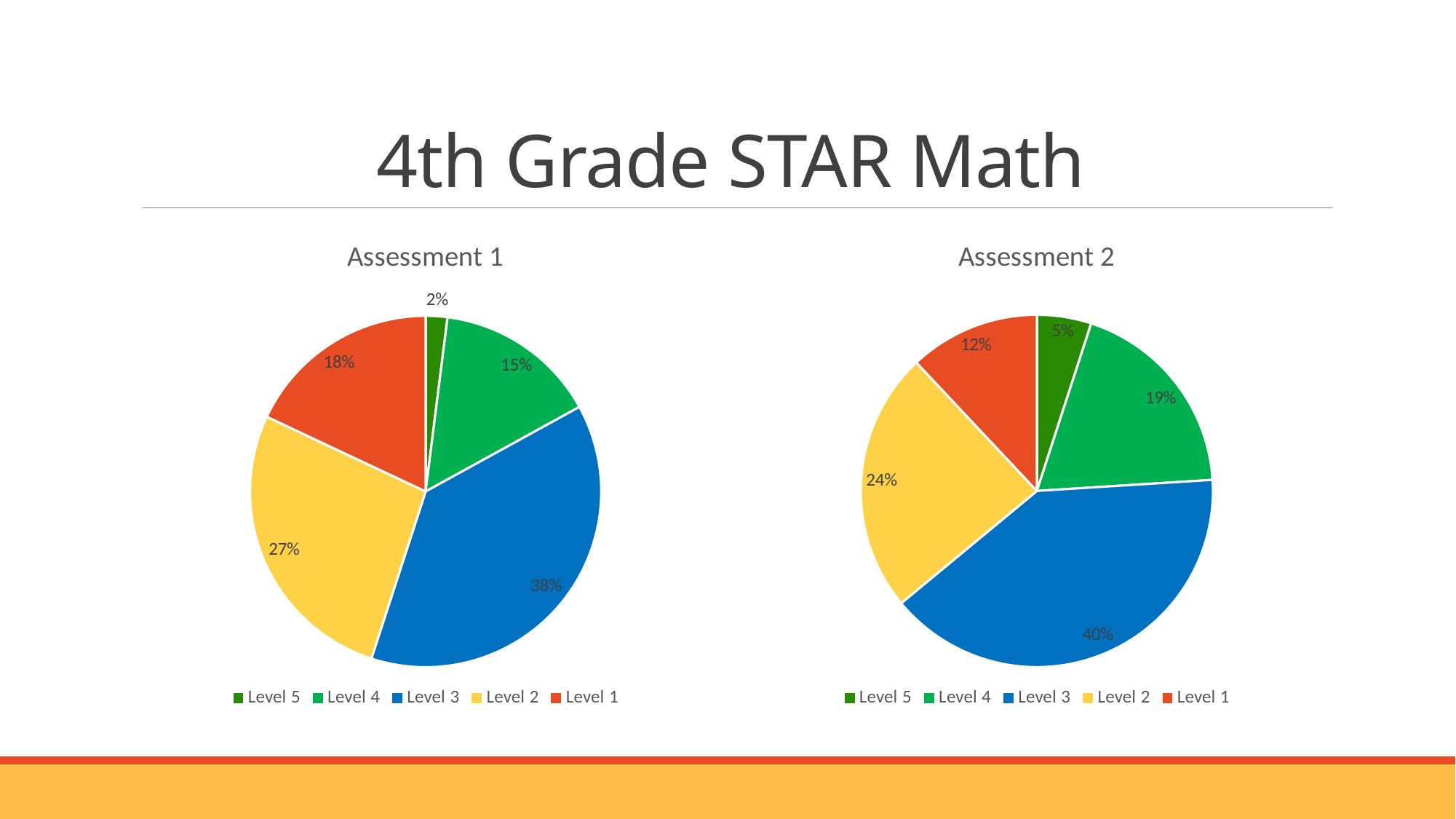
Which is larger: Level 4 in Assessment 1 or Level 4 in Assessment 2? Level 4 in Assessment 2 In the Assessment 2 chart, what is the difference between the Level 3 and Level 4 percentages? 21% In the Assessment 1 chart, what is the difference between the Level 2 and Level 1 percentages? 9% In the Assessment 2 chart, what percentage is shown for Level 2? 24% In the Assessment 2 chart, what percentage is shown for Level 1? 12% What type of chart is used for Assessment 2? Pie chart In the Assessment 1 chart, which level has the largest slice? Level 3 In the Assessment 2 chart, what colour represents Level 3? Blue In the Assessment 1 chart, what percentage is shown for Level 5? 2% How many slices does the Assessment 1 pie chart have? 5 In the Assessment 1 chart, what percentage is shown for Level 3? 38% In the Assessment 2 chart, which level has the smallest slice? Level 5